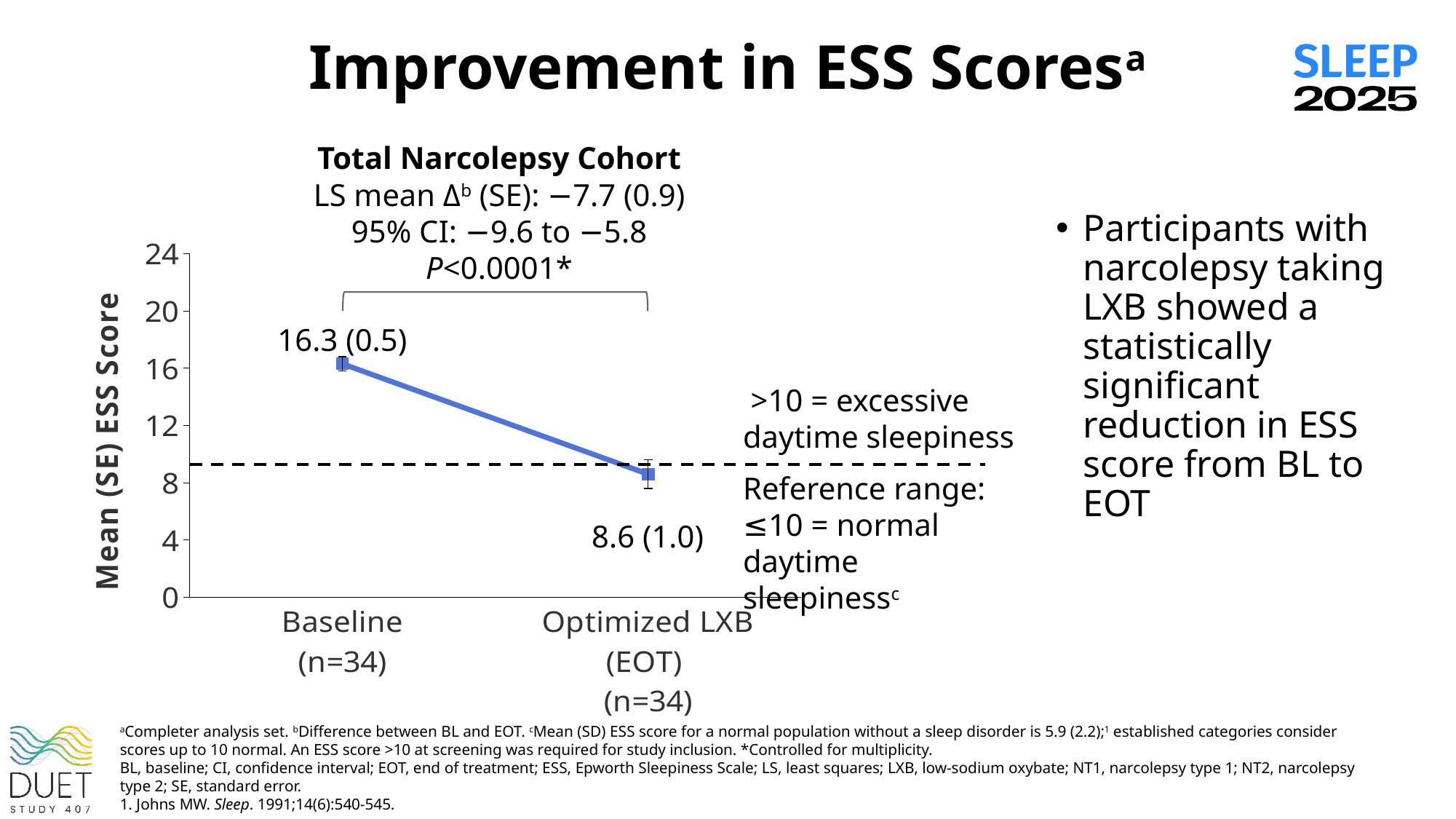
Which time point has the lowest mean ESS score? Optimized LXB (EOT) Is the mean ESS score at Baseline greater or less than 12? greater Is the mean ESS score at Optimized LXB (EOT) greater or less than 12? less Does the mean ESS score rise or fall from Baseline to Optimized LXB (EOT)? fall Which time point has the higher mean ESS score, Baseline or Optimized LXB (EOT)? Baseline What is the mean (SE) ESS score at Baseline? 16.3 (0.5) What type of chart is shown on the slide? line chart What is the LS mean change (SE) in ESS score shown above the chart? −7.7 (0.9) What is the mean (SE) ESS score at Optimized LXB (EOT)? 8.6 (1.0) What is the label of the y axis? Mean (SE) ESS Score What is the difference between the Baseline mean ESS score and the EOT mean ESS score? 7.7 How many time points are plotted on the chart? 2